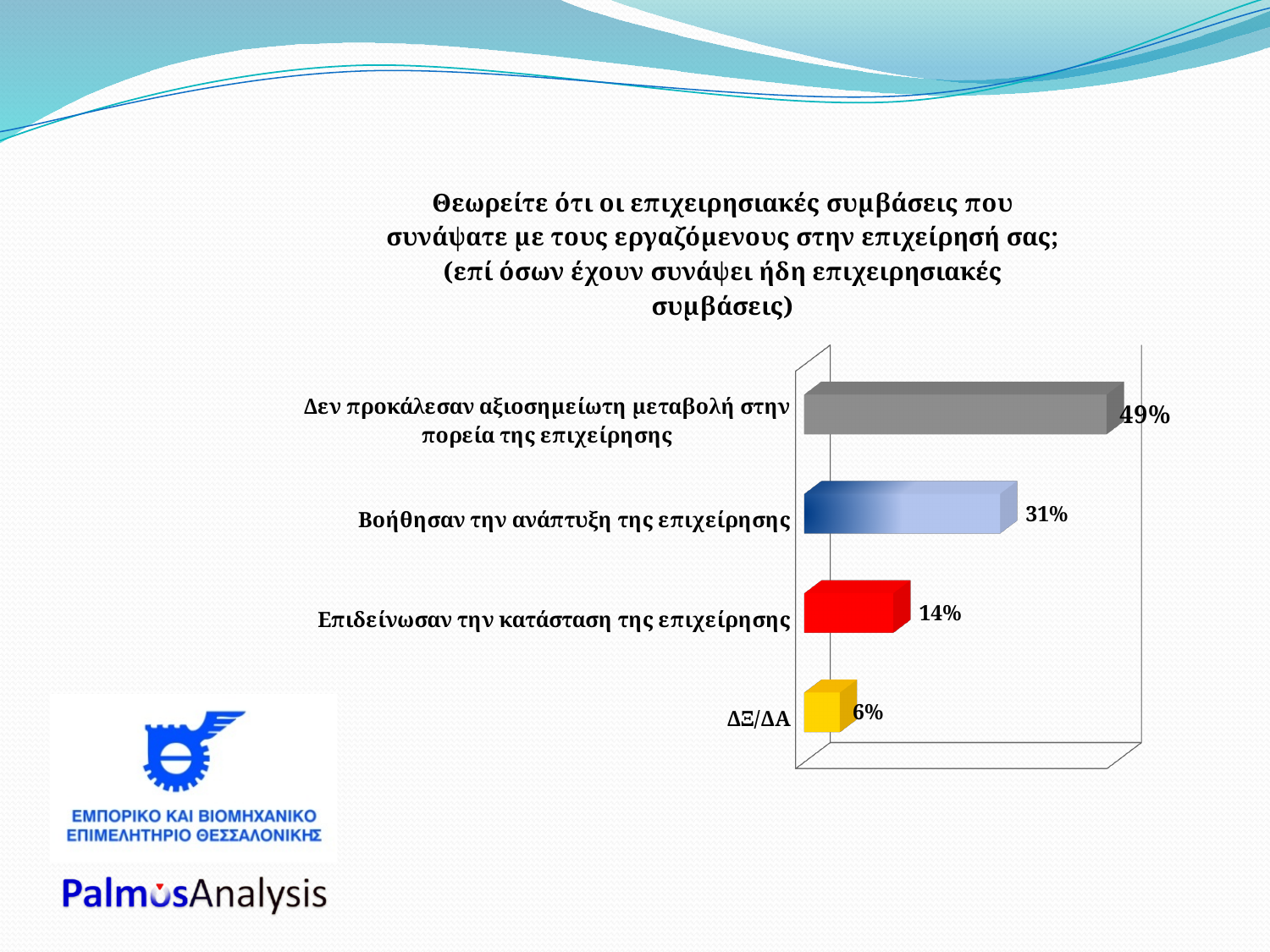
What colour is the bar for "Επιδείνωσαν την κατάσταση της επιχείρησης"? Red What is the value for "Βοήθησαν την ανάπτυξη της επιχείρησης"? 31% What kind of chart is shown on the slide? Bar chart Which is larger, the value for "Βοήθησαν την ανάπτυξη της επιχείρησης" or the value for "Επιδείνωσαν την κατάσταση της επιχείρησης"? Βοήθησαν την ανάπτυξη της επιχείρησης What is the difference between the values for "Δεν προκάλεσαν αξιοσημείωτη μεταβολή στην πορεία της επιχείρησης" and "Βοήθησαν την ανάπτυξη της επιχείρησης"? 18% Which category has the highest value? Δεν προκάλεσαν αξιοσημείωτη μεταβολή στην πορεία της επιχείρησης How many categories are shown in the chart? 4 Which category has the lowest value? ΔΞ/ΔΑ What is the value for "ΔΞ/ΔΑ"? 6% What is the value for "Επιδείνωσαν την κατάσταση της επιχείρησης"? 14% What is the difference between the values for "Επιδείνωσαν την κατάσταση της επιχείρησης" and "ΔΞ/ΔΑ"? 8% What is the value for "Δεν προκάλεσαν αξιοσημείωτη μεταβολή στην πορεία της επιχείρησης"? 49%